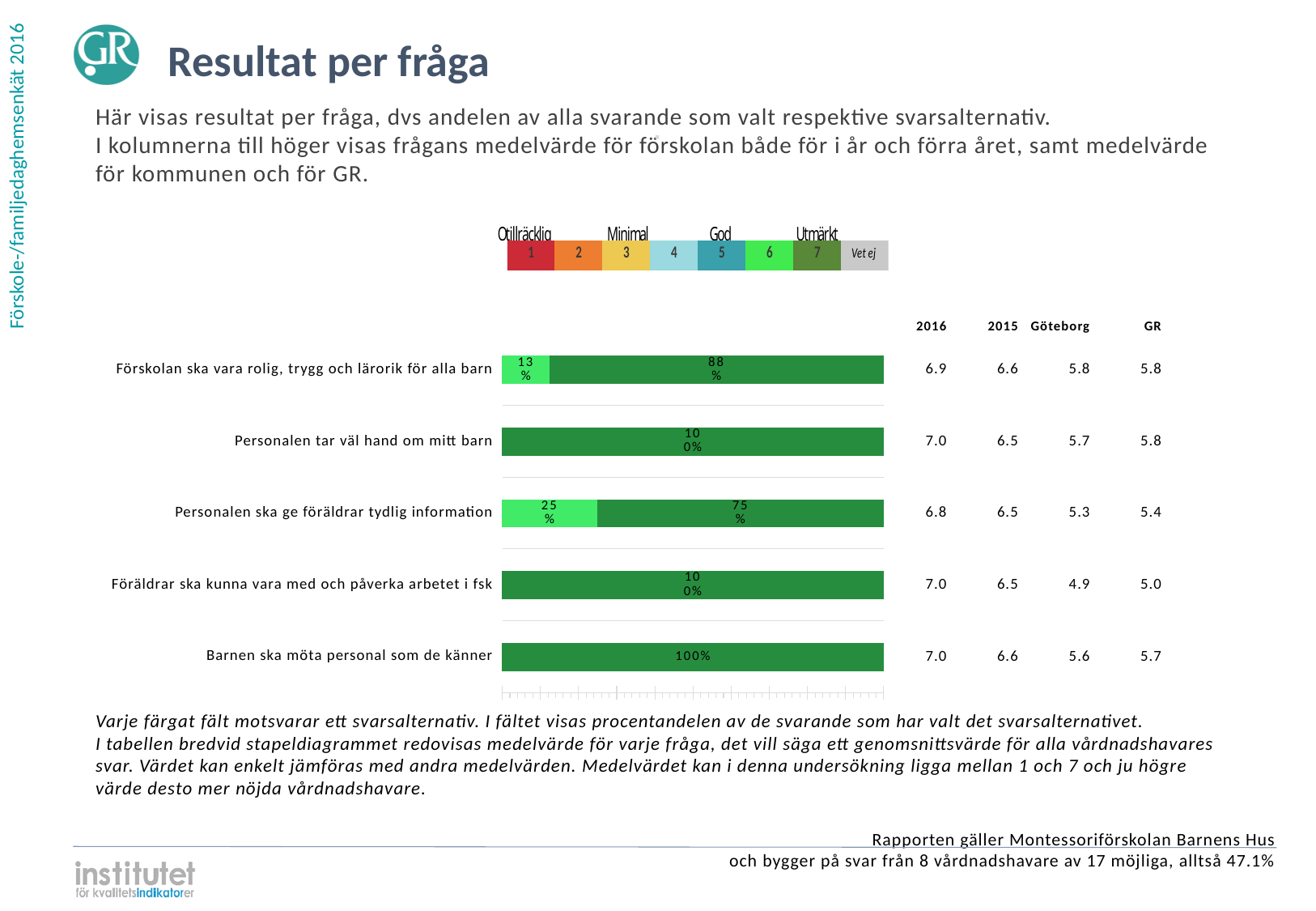
What is the 2016 mean value shown for "Personalen ska ge föräldrar tydlig information"? 6.8 How many answer options does the colour legend above the chart list? 8 Which has a larger share of option 7 (dark green) responses: "Förskolan ska vara rolig, trygg och lärorik för alla barn" or "Personalen ska ge föräldrar tydlig information"? Förskolan ska vara rolig, trygg och lärorik för alla barn What percentage of respondents chose answer option 7 (dark green) for "Förskolan ska vara rolig, trygg och lärorik för alla barn"? 88% For "Personalen ska ge föräldrar tydlig information", what is the difference between the share choosing option 7 and the share choosing option 6? 50% What kind of chart is used to show the results per question? Stacked horizontal bar chart For "Förskolan ska vara rolig, trygg och lärorik för alla barn", what is the difference between the share choosing option 7 and the share choosing option 6? 75% Which question has the smallest share of respondents choosing answer option 7 (dark green)? Personalen ska ge föräldrar tydlig information What percentage is shown on the bar for "Barnen ska möta personal som de känner"? 100% How many questions (categories) are plotted in the bar chart? 5 What percentage of respondents chose answer option 6 (light green) for "Förskolan ska vara rolig, trygg och lärorik för alla barn"? 13% What percentage of respondents chose answer option 6 (light green) for "Personalen ska ge föräldrar tydlig information"? 25%